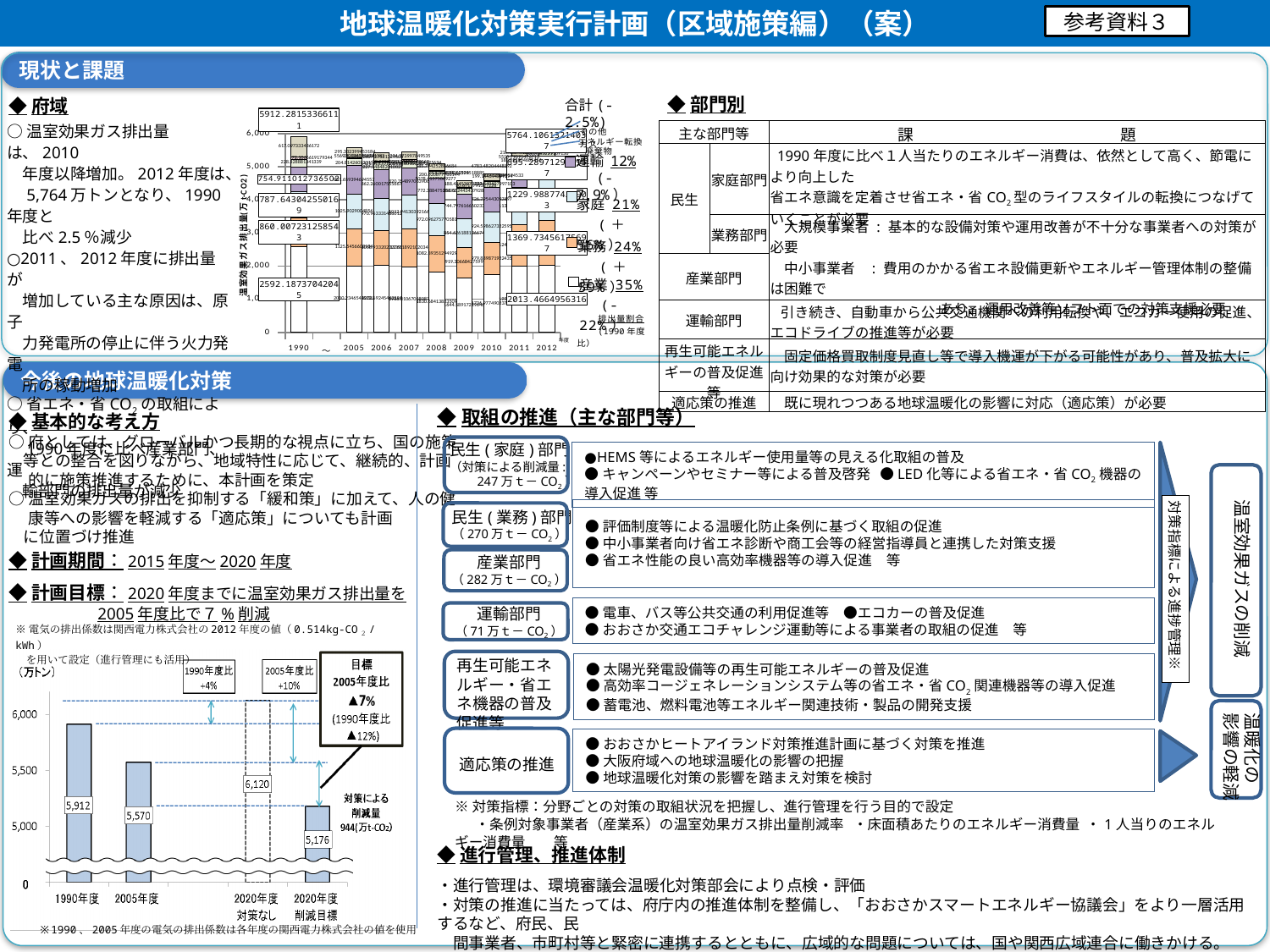
In the bottom-left bar chart, what is the value for 1990年度? 5,912 In the bottom-left bar chart, what is the value for 2020年度 対策なし? 6,120 What kind of chart is the bottom-left chart on the slide? bar chart In the bottom-left bar chart, which category has the highest value? 2020年度 対策なし What kind of chart is the top chart showing 温室効果ガス排出量 by year? stacked bar chart In the bottom-left bar chart, what is the difference between the 1990年度 value and the 2005年度 value? 342 How many bars are shown in the bottom-left bar chart? 4 In the bottom-left bar chart, which category has the lowest value? 2020年度 削減目標 In the bottom-left bar chart, what is the value for 2020年度 削減目標? 5,176 In the bottom-left bar chart, what is the difference between 2020年度 対策なし and 2020年度 削減目標? 944 In the bottom-left bar chart, what is the value for 2005年度? 5,570 In the bottom-left bar chart, which is larger, the value for 1990年度 or the value for 2005年度? 1990年度